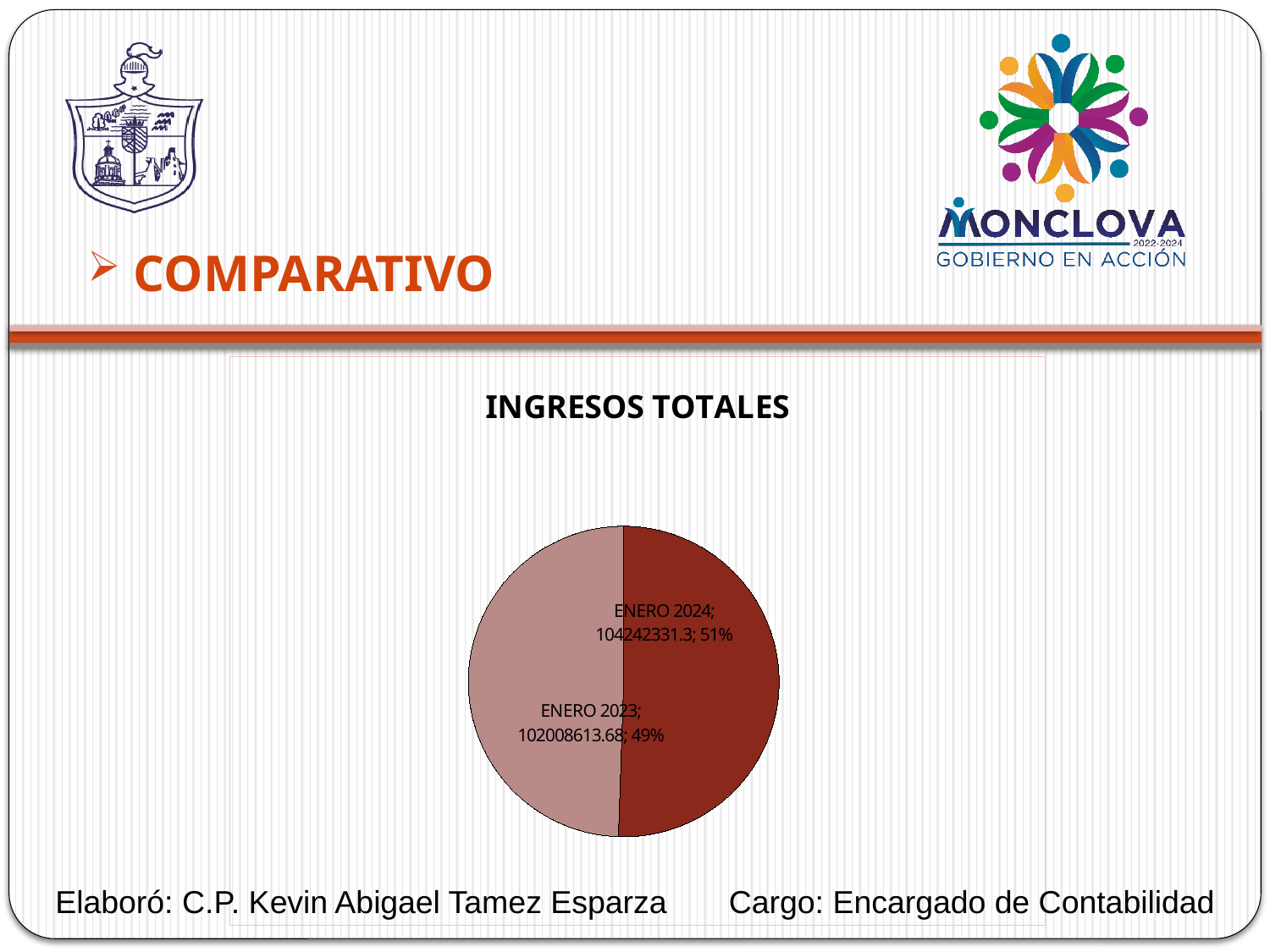
Which is larger, the value for ENERO 2024 or ENERO 2023? ENERO 2024 What is the title of the chart? INGRESOS TOTALES Which slice is the smallest? ENERO 2023 What is the difference between the values for ENERO 2024 and ENERO 2023? 2233717.62 What is the value for ENERO 2023? 102008613.68 What share of the pie does ENERO 2024 represent? 51% What share of the pie does ENERO 2023 represent? 49% What is the value for ENERO 2024? 104242331.3 How many slices does the pie chart have? 2 What is the total of the two values shown in the pie chart? 206250944.98 What type of chart is shown on the slide? pie chart Which slice is the largest? ENERO 2024